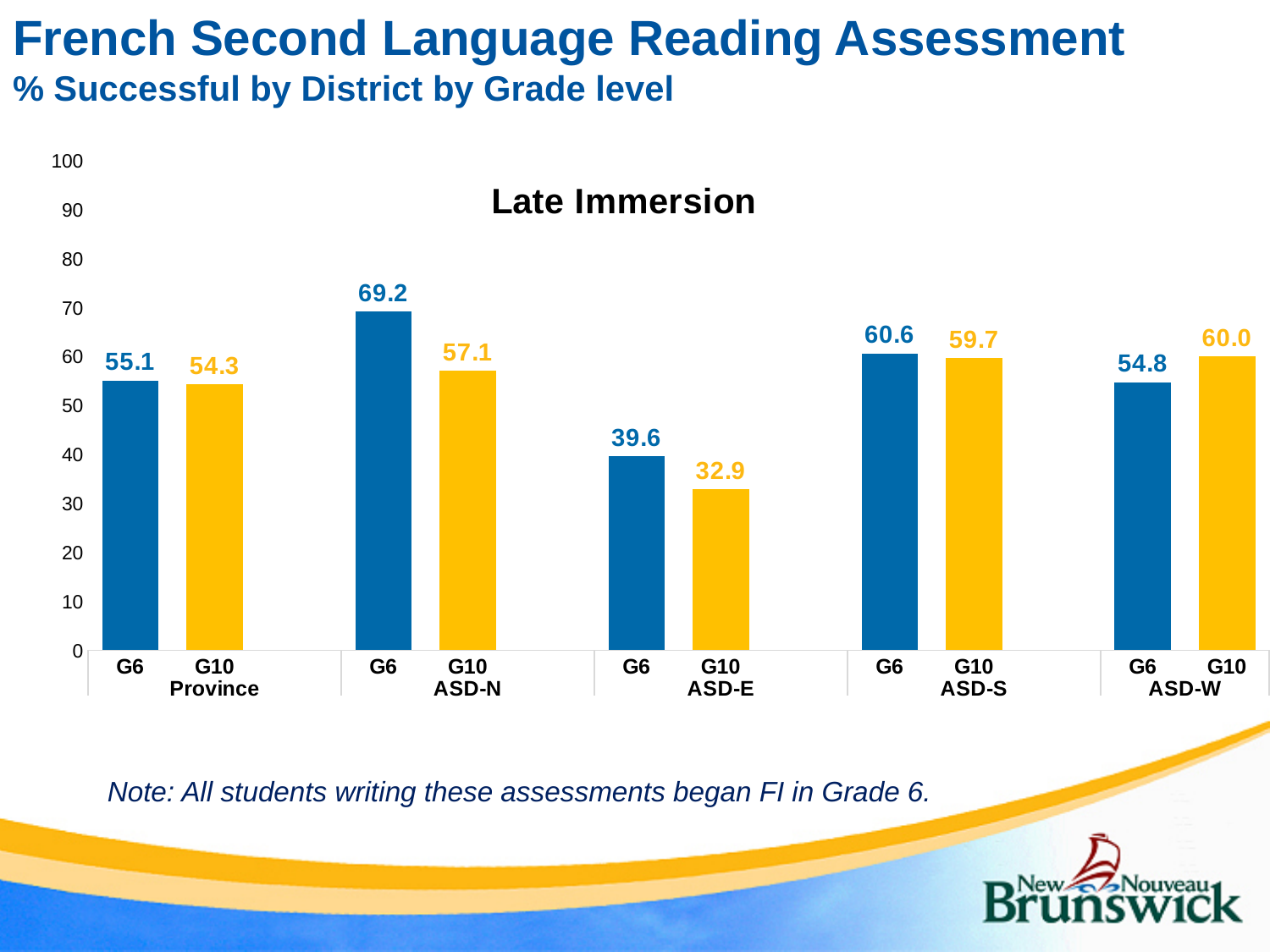
What is the title shown inside the chart area? Late Immersion Is the G6 value for ASD-E greater or less than 40? less What is the G10 value for the Province? 54.3 What is the G6 value for ASD-N? 69.2 What kind of chart is shown on the slide? bar chart What is the difference between the G6 values for ASD-N and ASD-S? 8.6 What is the difference between the G6 and G10 values for ASD-E? 6.7 What is the G10 value for ASD-E? 32.9 Which district has the lowest G10 value? ASD-E How many districts (including Province) are shown on the chart? 5 Which is larger for ASD-W, the G6 value or the G10 value? G10 Which district has the highest G6 value? ASD-N